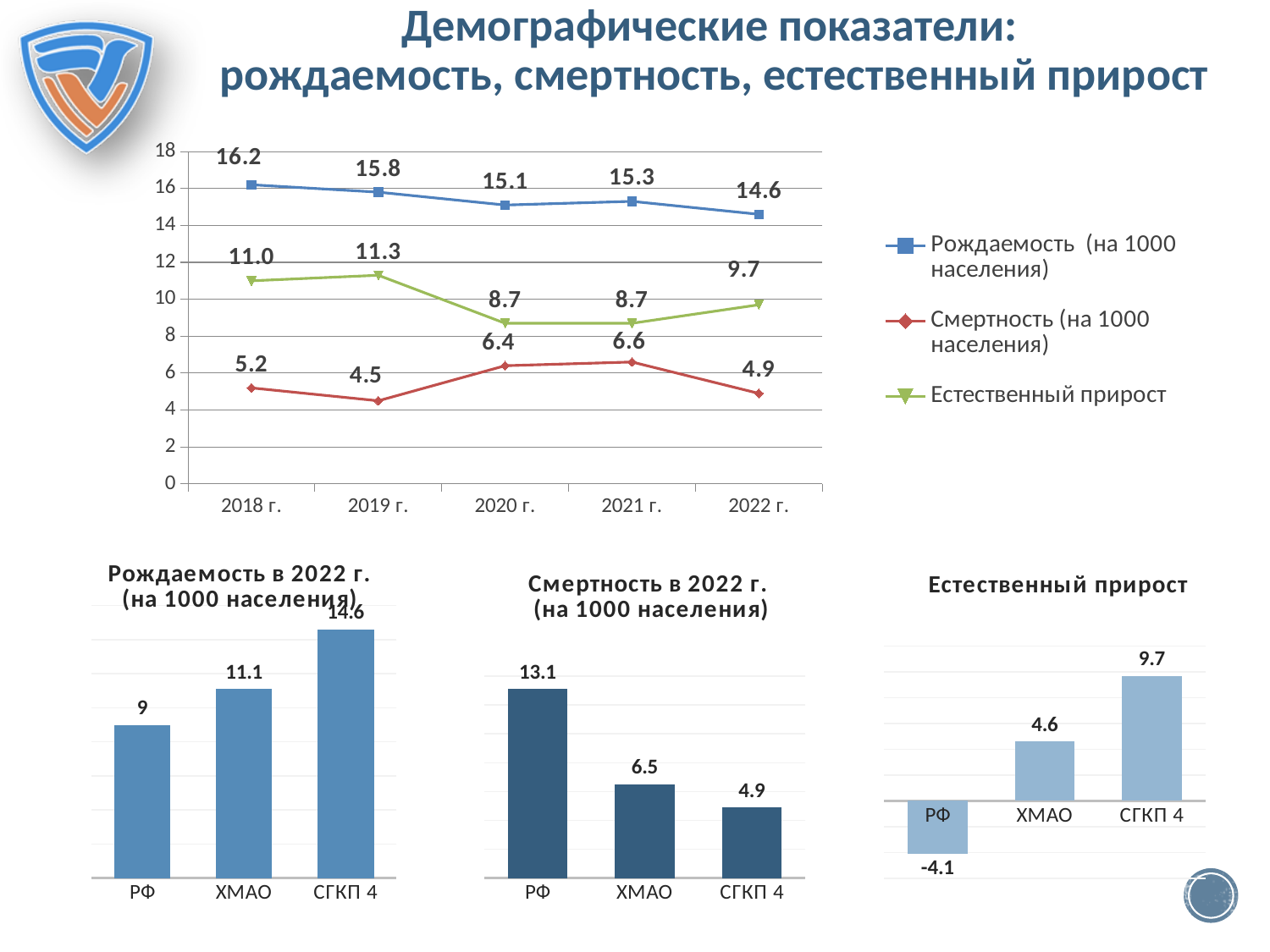
In the chart titled 'Смертность в 2022 г. (на 1000 населения)', what is the difference between РФ and СГКП 4? 8.2 In the chart titled 'Рождаемость в 2022 г. (на 1000 населения)', what is the value for ХМАО? 11.1 In the top line chart, what is the value of Рождаемость (на 1000 населения) for 2018 г.? 16.2 What type of chart is the bottom-right chart titled 'Естественный прирост'? bar chart In the top line chart, does Рождаемость (на 1000 населения) generally rise or fall from 2018 г. to 2022 г.? fall In the top line chart, in which year is Естественный прирост highest? 2019 г. In the top line chart, what is the difference between Рождаемость in 2018 г. and 2022 г.? 1.6 In the top line chart, what is the value of Смертность (на 1000 населения) for 2021 г.? 6.6 In the bottom-right chart titled 'Естественный прирост', what is the value for РФ? -4.1 In the top line chart, in which year is Смертность (на 1000 населения) lowest? 2019 г. In the top line chart, how many series does the legend list? 3 In the chart titled 'Смертность в 2022 г. (на 1000 населения)', which category has the highest value? РФ